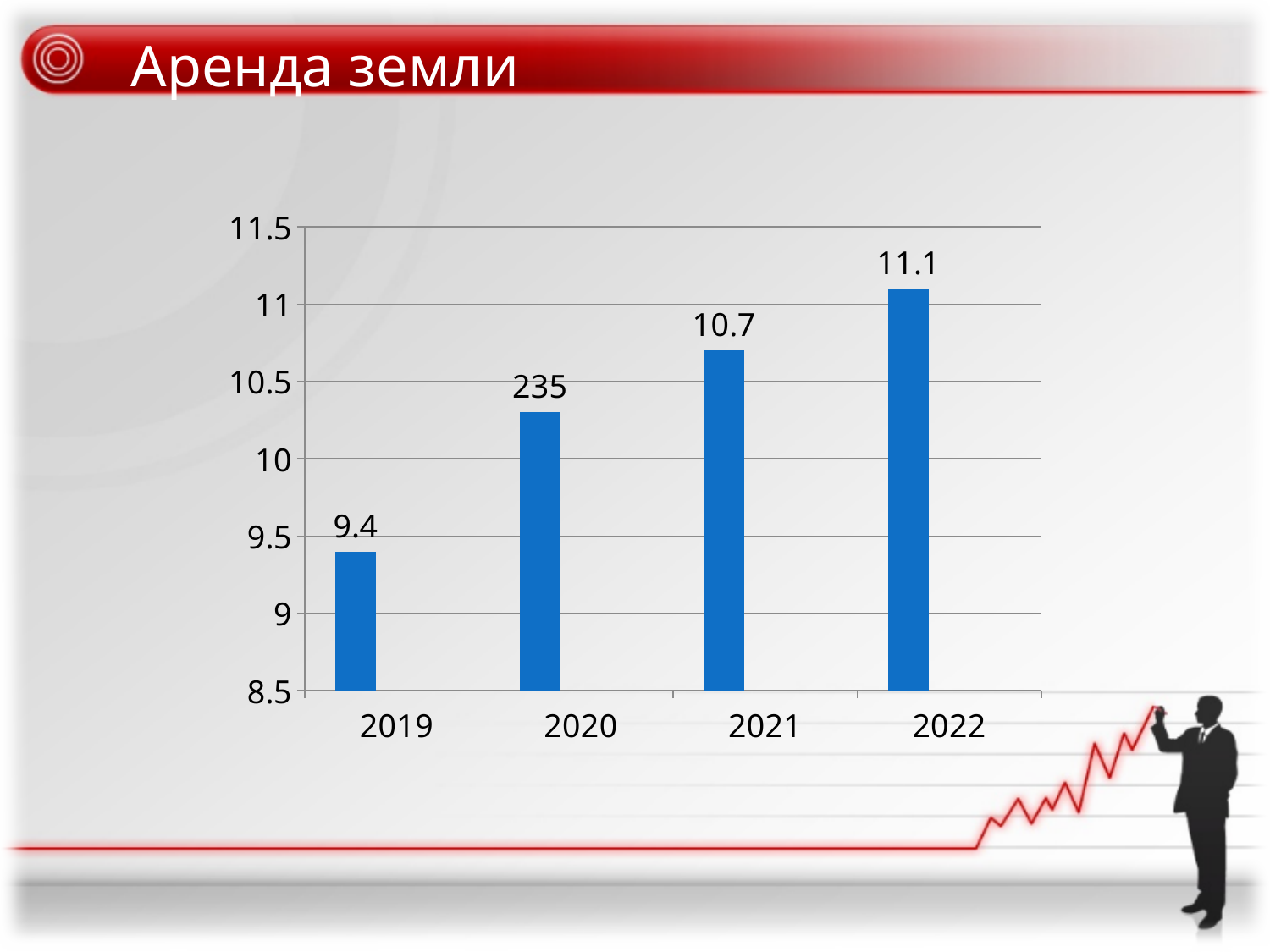
How many years are shown on the x axis? 4 Is the value for 2020 greater or less than 10? greater What is the value for 2019? 9.4 What is the difference between the values for 2022 and 2019? 1.7 What kind of chart is shown on the slide? bar chart Which year has the highest bar? 2022 What is the difference between the values for 2022 and 2021? 0.4 Do the values rise or fall from 2019 to 2022? rise What is the value for 2022? 11.1 Which is larger, the value for 2021 or the value for 2019? 2021 Which year has the lowest bar? 2019 What is the value for 2021? 10.7